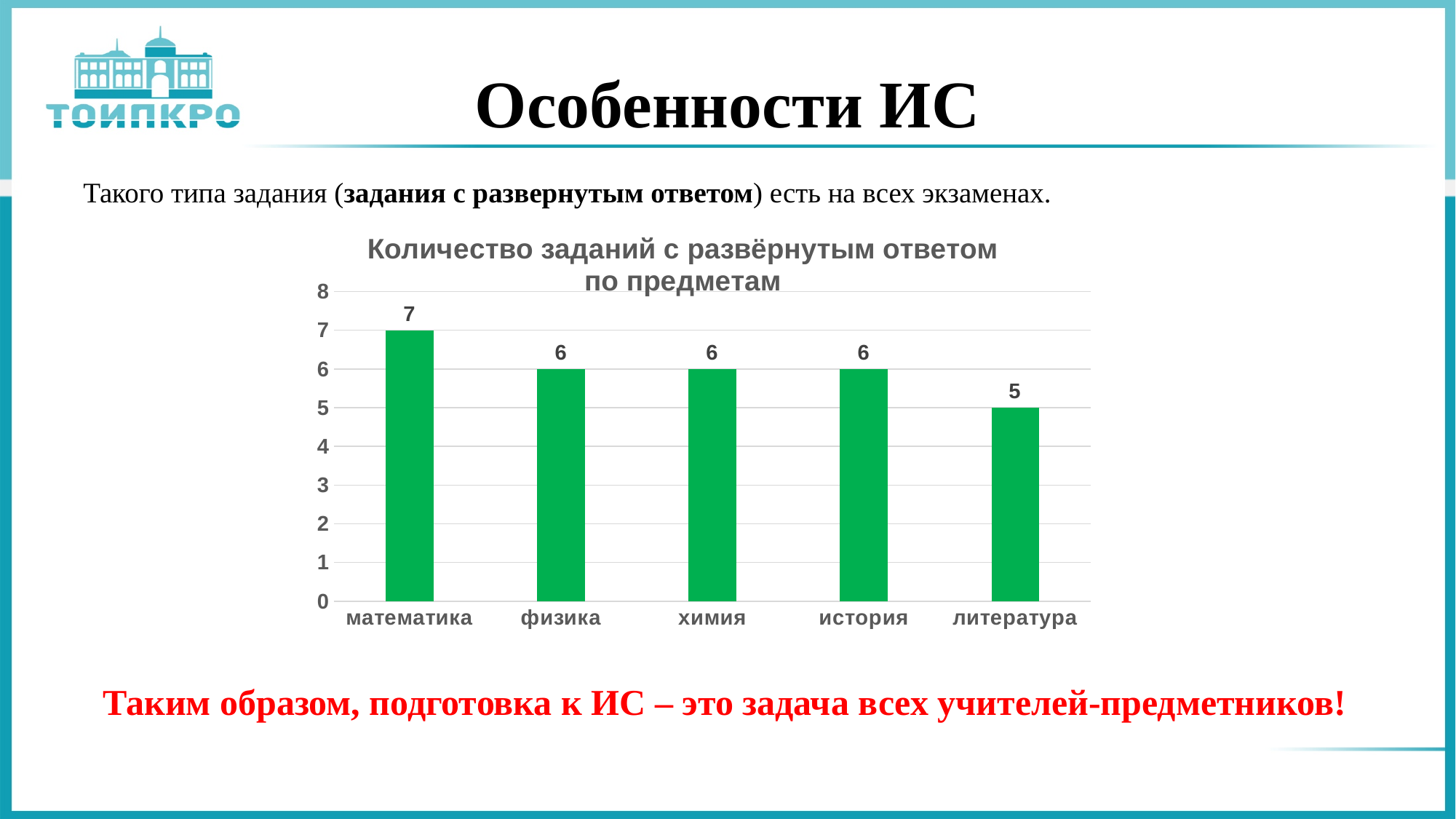
Which is larger, the value for химия or the value for литература? химия What is the value for математика? 7 What is the title of the chart? Количество заданий с развёрнутым ответом по предметам What is the value for физика? 6 What kind of chart is this? bar chart Which category has the lowest value? литература Which category has the highest value? математика How many categories are shown on the x axis? 5 What is the difference between the values for математика and литература? 2 Is the value for история greater or less than 4? greater Do the values rise or fall from математика to литература along the x axis? fall What is the value for литература? 5